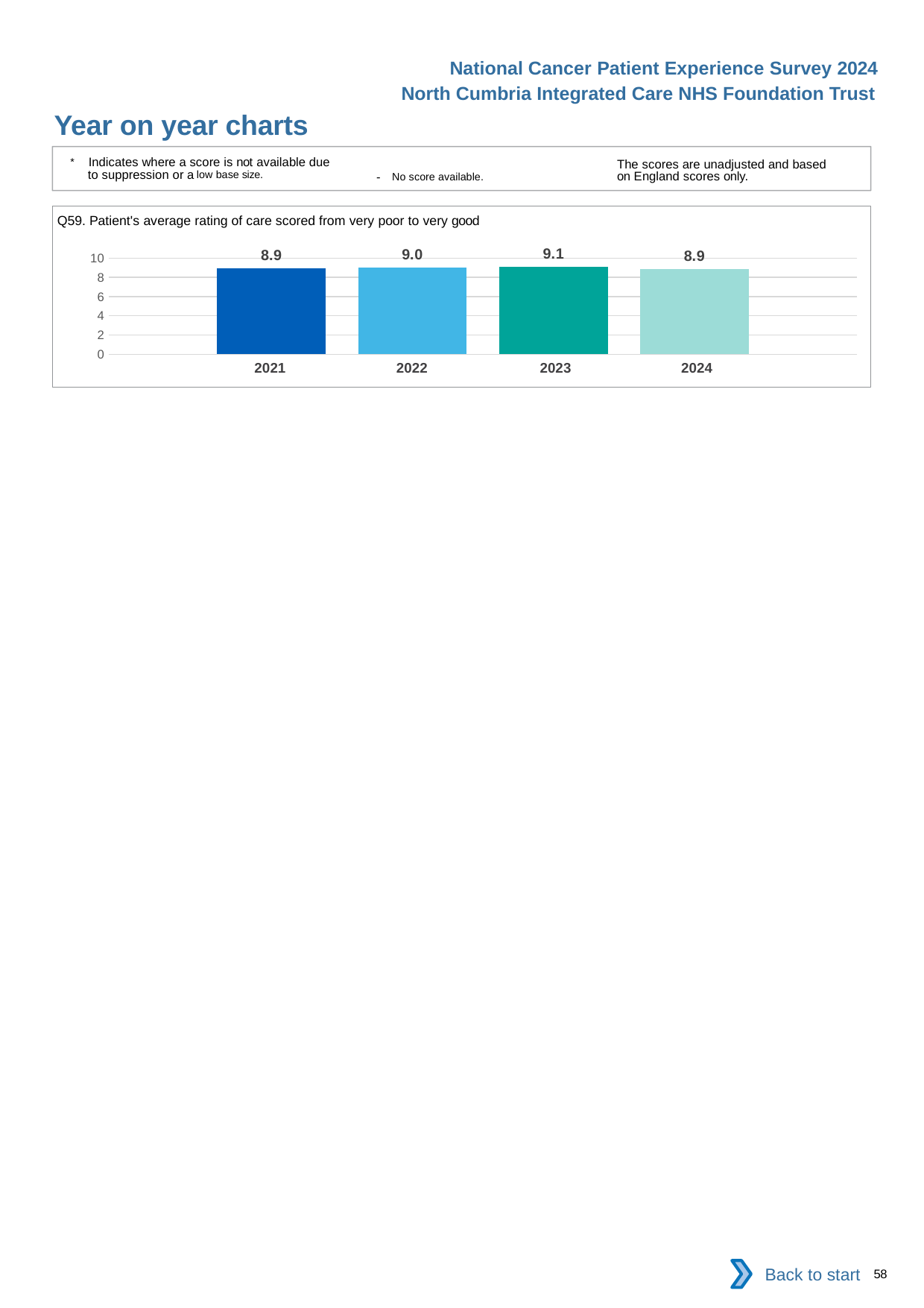
Which is larger, the value for 2023 or the value for 2021? 2023 What is the difference between the values for 2022 and 2021? 0.1 What is the title of the chart? Q59. Patient's average rating of care scored from very poor to very good What is the value for 2021? 8.9 Which year has the highest value? 2023 What is the value for 2024? 8.9 What is the value for 2023? 9.1 What kind of chart is shown? bar chart What is the value for 2022? 9.0 What is the difference between the values for 2023 and 2024? 0.2 How many years are shown on the chart? 4 Is the value for 2022 greater or less than 8? greater